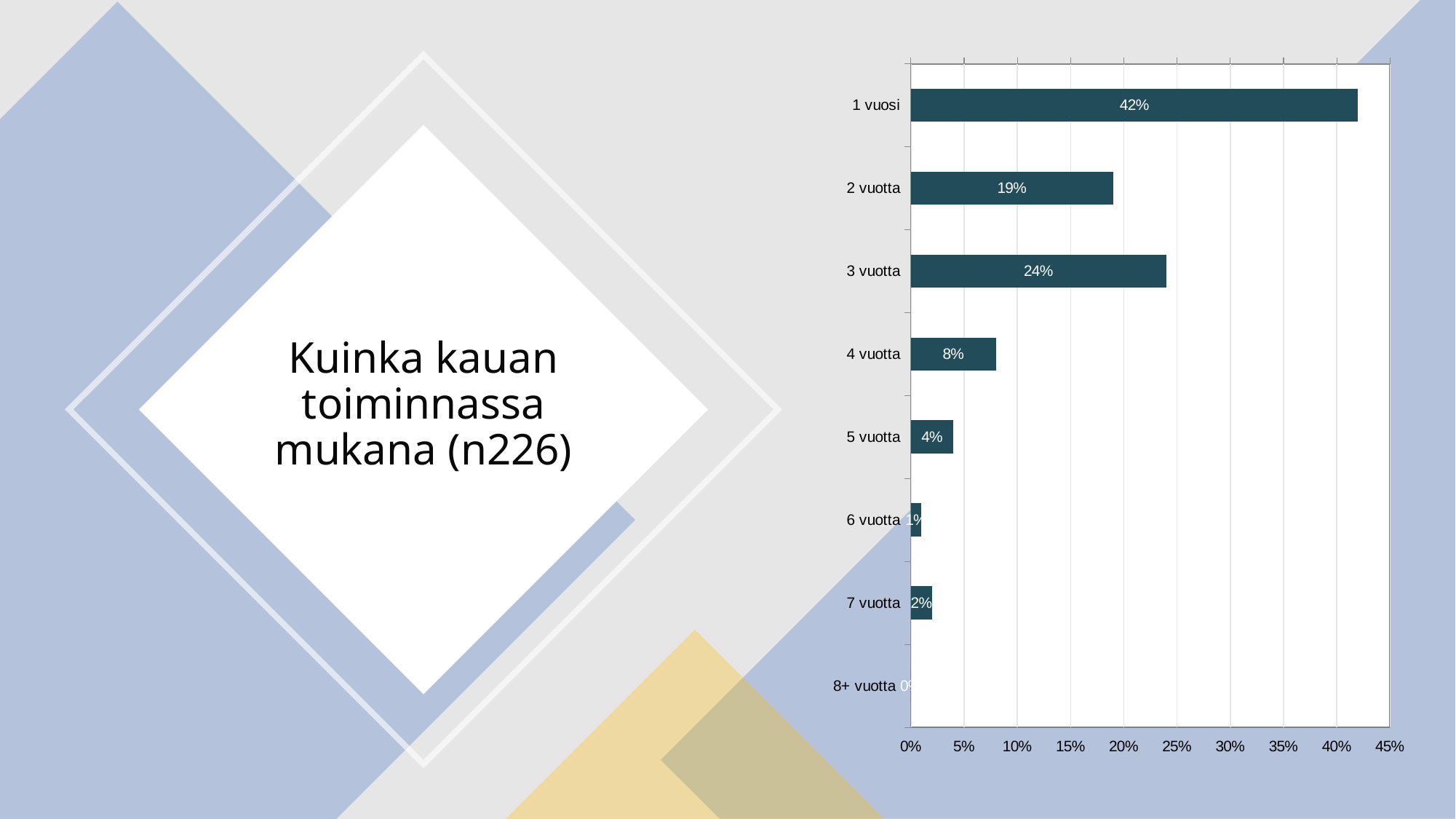
What is the value for 1 vuosi? 42% What kind of chart is shown on the slide? bar chart What is the value for 5 vuotta? 4% What is the title shown next to the chart? Kuinka kauan toiminnassa mukana (n226) What is the difference between the values for 1 vuosi and 2 vuotta? 23% What is the value for 3 vuotta? 24% Is the value for 2 vuotta greater or less than 15%? greater Which category has the highest value? 1 vuosi Which category has the lowest value? 8+ vuotta What is the difference between the values for 3 vuotta and 4 vuotta? 16% Which is larger, the value for 2 vuotta or the value for 3 vuotta? 3 vuotta How many categories are shown on the chart? 8